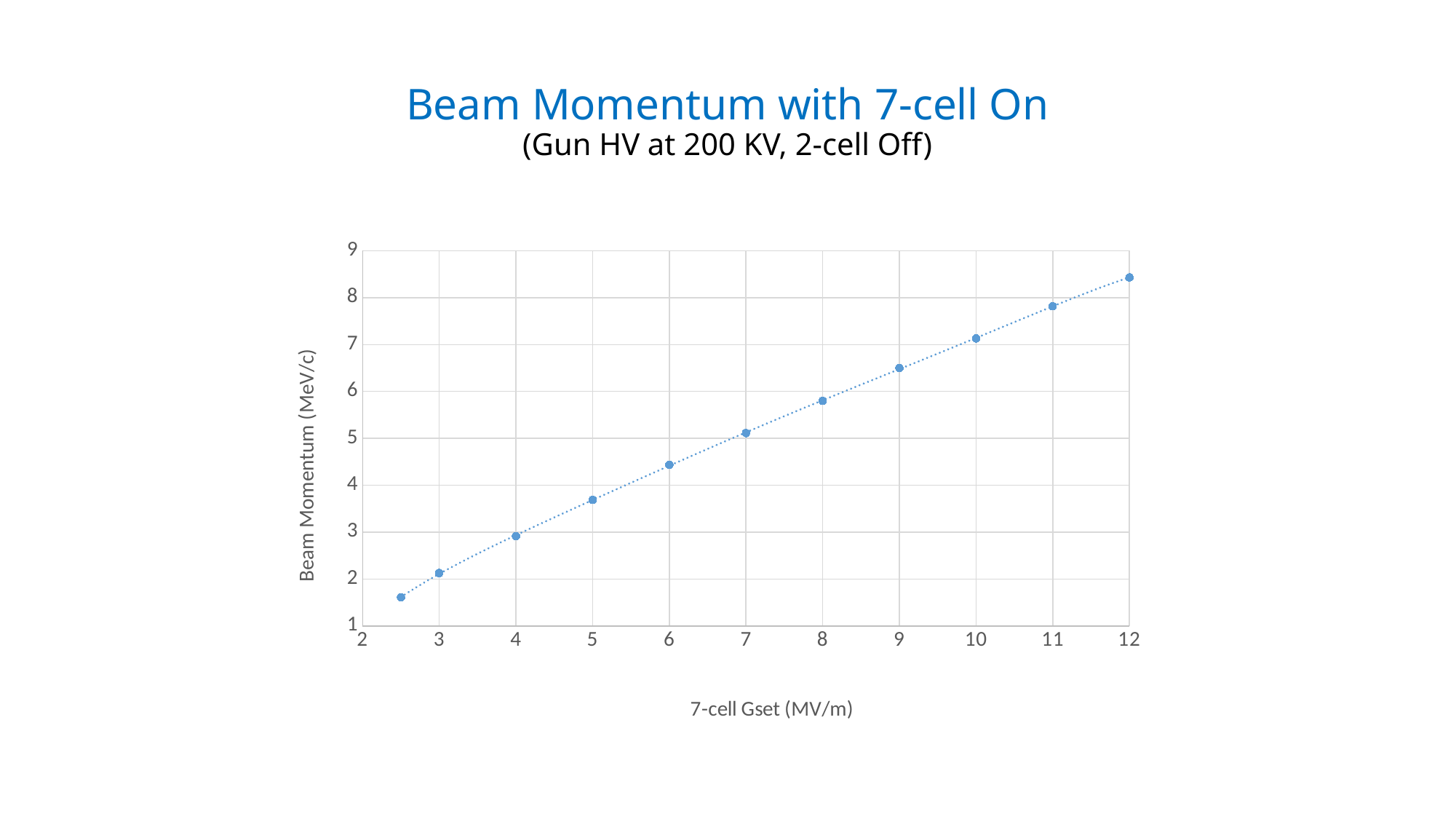
Does beam momentum rise or fall as 7-cell Gset increases? Rises Is the beam momentum at a 7-cell Gset of 6 MV/m greater or less than 4? greater How many data points are plotted on the chart? 11 What kind of chart is shown on the slide? Scatter chart What is the label of the y axis? Beam Momentum (MeV/c) At which 7-cell Gset value is the beam momentum lowest? 2.5 Is the beam momentum at a 7-cell Gset of 12 MV/m greater or less than 8? greater Is the beam momentum at a 7-cell Gset of 2.5 MV/m greater or less than 2? less At which 7-cell Gset value is the beam momentum highest? 12 What is the title of the chart? Beam Momentum with 7-cell On Which has the larger beam momentum: a 7-cell Gset of 9 MV/m or 4 MV/m? 9 MV/m